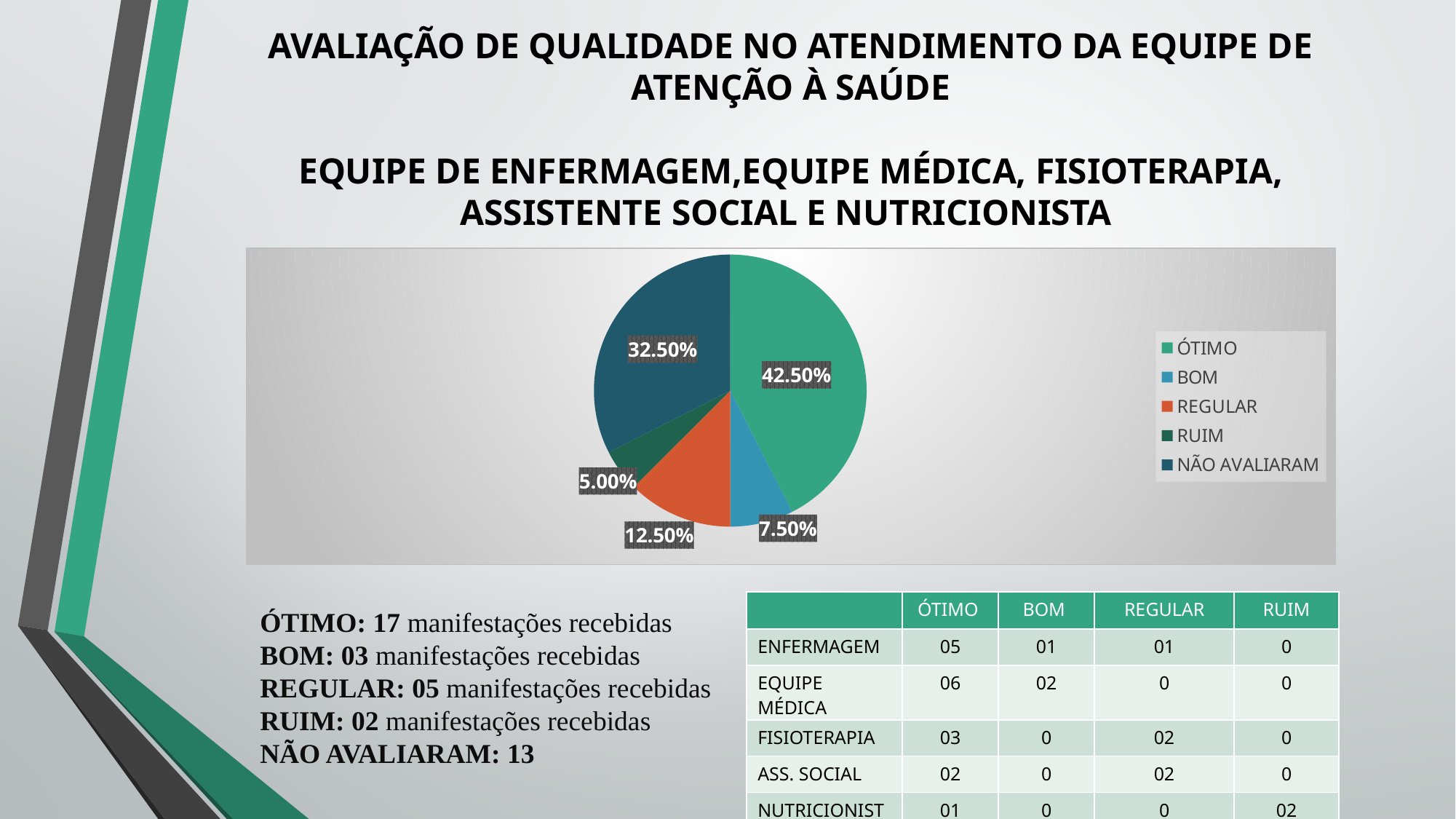
How many slices does the pie chart have? 5 What percentage of the pie chart is labelled ÓTIMO? 42.50% Which category has the largest slice of the pie chart? ÓTIMO Which category has the smallest slice of the pie chart? RUIM What percentage of the pie chart is labelled NÃO AVALIARAM? 32.50% What is the difference in percentage points between the ÓTIMO slice and the NÃO AVALIARAM slice? 10 percentage points What kind of chart is shown on the slide? pie chart Which slice is larger in the pie chart, REGULAR or BOM? REGULAR What percentage of the pie chart is labelled RUIM? 5.00% What percentage of the pie chart is labelled BOM? 7.50% How many entries does the pie chart legend list? 5 What percentage of the pie chart is labelled REGULAR? 12.50%